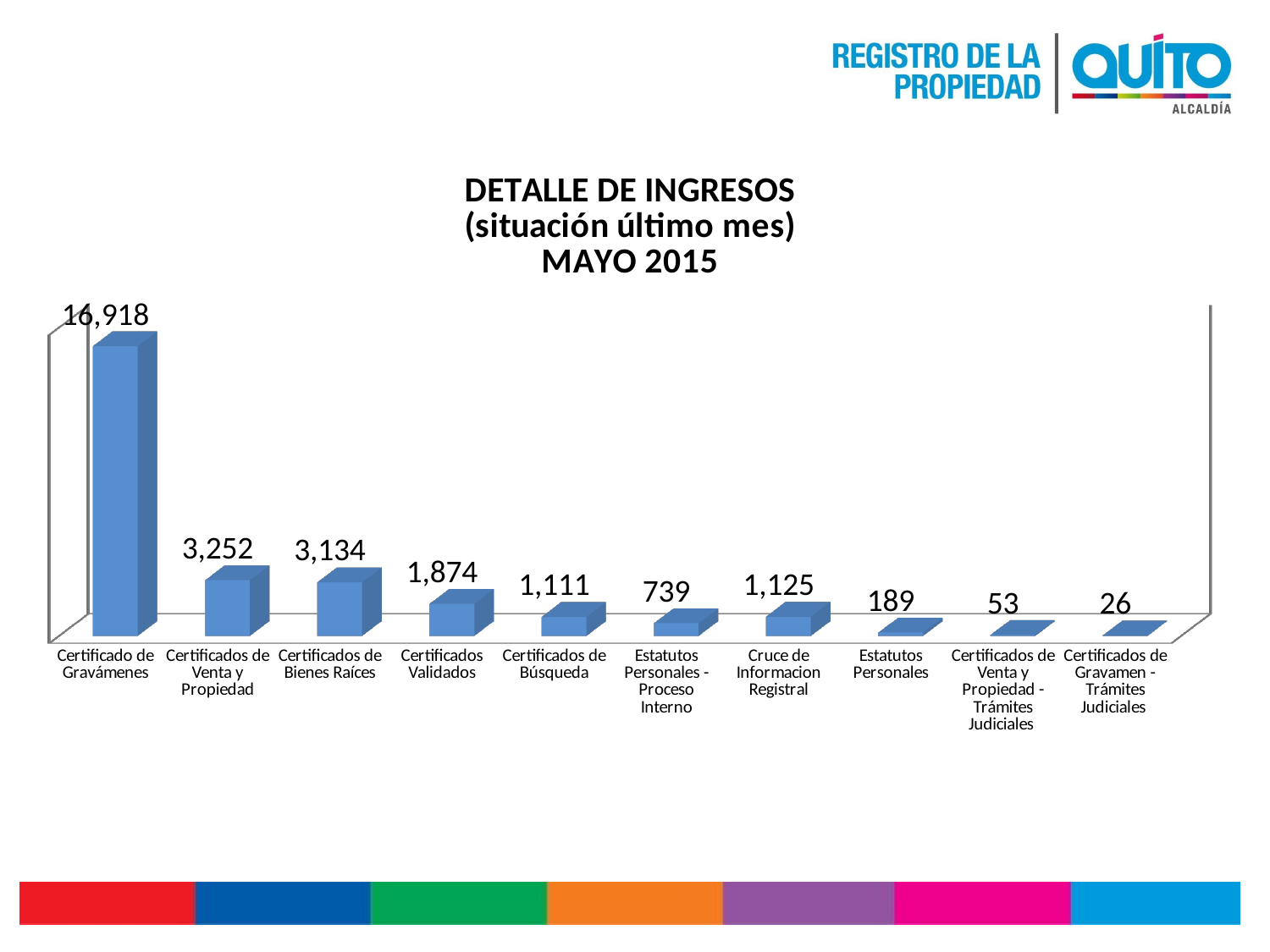
Which category has the lowest value? Certificados de Gravamen - Trámites Judiciales What is the value for Estatutos Personales - Proceso Interno? 739 What is the difference between Certificados de Venta y Propiedad and Certificados de Bienes Raíces? 118 What is the value for Cruce de Informacion Registral? 1,125 What is the title of the chart? DETALLE DE INGRESOS (situación último mes) MAYO 2015 What is the difference between Certificados Validados and Certificados de Búsqueda? 763 Which is larger, Cruce de Informacion Registral or Certificados de Búsqueda? Cruce de Informacion Registral What kind of chart is shown on the slide? Bar chart What is the value for Certificado de Gravámenes? 16,918 Which category has the highest value? Certificado de Gravámenes How many categories are shown in the chart? 10 What is the value for Certificados de Bienes Raíces? 3,134